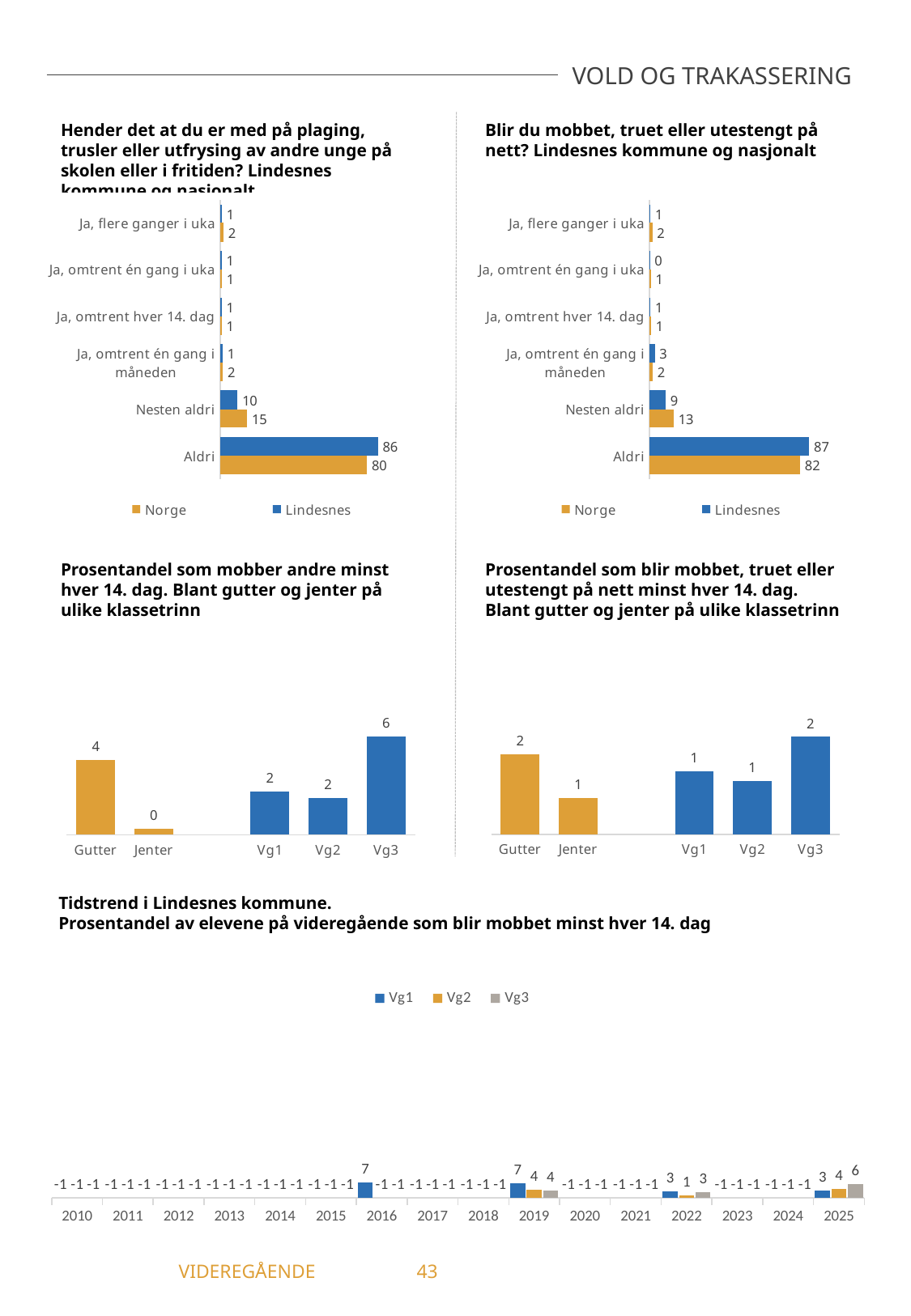
How many series does the legend list in the top-right chart ("Blir du mobbet, truet eller utestengt på nett?")? 2 In the middle-left chart ("Prosentandel som mobber andre minst hver 14. dag"), what is the value for Jenter? 0 In the top-right chart ("Blir du mobbet, truet eller utestengt på nett?"), which is larger for "Aldri": Lindesnes or Norge? Lindesnes In the bottom chart ("Tidstrend i Lindesnes kommune"), what is the value for Vg3 in 2025? 6 What kind of chart is the bottom chart ("Tidstrend i Lindesnes kommune")? Bar chart In the middle-left chart ("Prosentandel som mobber andre minst hver 14. dag"), which category has the highest value? Vg3 In the top-left chart ("Hender det at du er med på plaging..."), what is the difference between the Lindesnes and Norge values for "Aldri"? 6 In the top-left chart ("Hender det at du er med på plaging..."), what is the value for Norge in the "Nesten aldri" category? 15 In the top-right chart ("Blir du mobbet, truet eller utestengt på nett?"), what is the value for Norge in the "Nesten aldri" category? 13 In the top-left chart ("Hender det at du er med på plaging..."), what is the value for Lindesnes in the "Aldri" category? 86 How many categories are shown on the x axis of the middle-right chart ("Prosentandel som blir mobbet, truet eller utestengt på nett minst hver 14. dag")? 5 In the middle-right chart ("Prosentandel som blir mobbet, truet eller utestengt på nett minst hver 14. dag"), what is the value for Gutter? 2